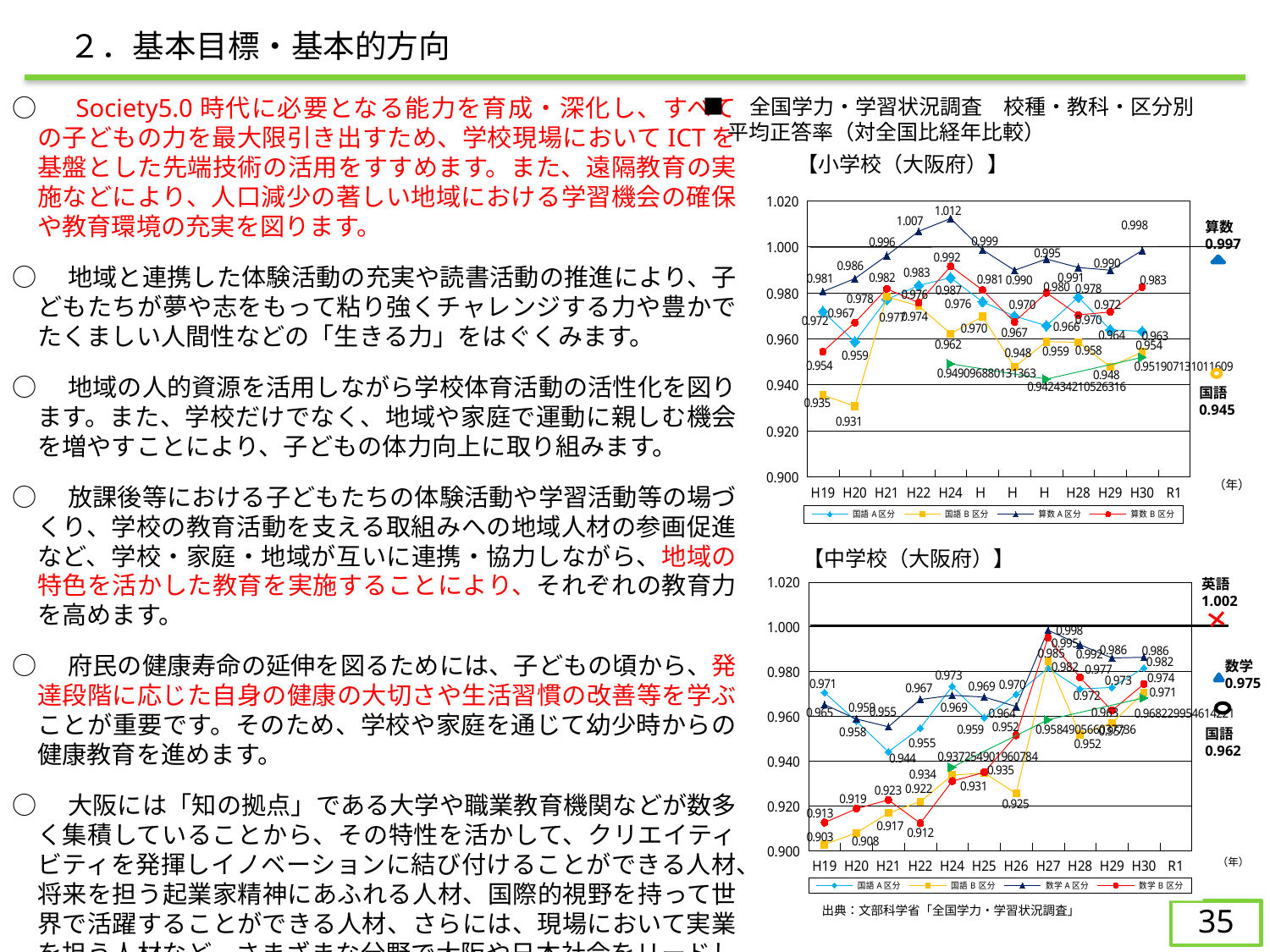
In the 【中学校（大阪府）】 chart, is the value of 国語B区分 at H19 greater or less than 0.920? less In the 【小学校（大阪府）】 chart, what is the R1 value shown for 算数? 0.997 In the 【小学校（大阪府）】 chart, which R1 value is larger, 算数 or 国語? 算数 In the 【中学校（大阪府）】 chart, what is the R1 value shown for 英語? 1.002 In the 【中学校（大阪府）】 chart, what is the value of 数学A区分 at H27? 0.998 How many series does the legend of the 【中学校（大阪府）】 chart list? 4 In the 【小学校（大阪府）】 chart, what is the difference between the 算数A区分 value at H24 and at H19? 0.031 In the 【小学校（大阪府）】 chart, in which year does the 算数A区分 series reach its highest value? H24 What kind of chart is the 【小学校（大阪府）】 chart? line chart In the 【小学校（大阪府）】 chart, what is the highest value of the 算数A区分 series? 1.012 In the 【小学校（大阪府）】 chart, what is the value of 算数A区分 at H19? 0.981 How many year categories are shown on the x axis of the 【中学校（大阪府）】 chart? 12